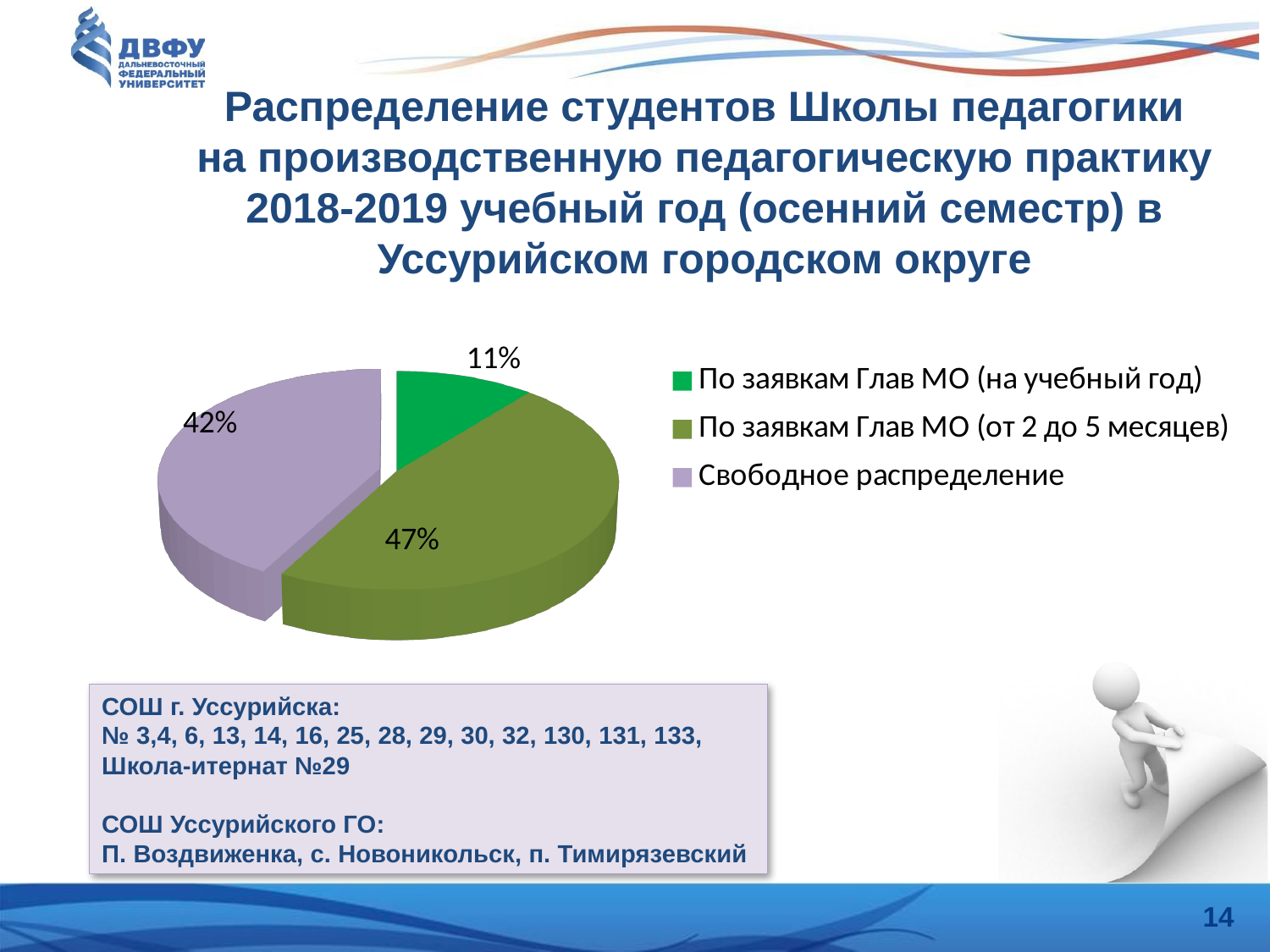
What is the difference in percentage points between "По заявкам Глав МО (от 2 до 5 месяцев)" and "Свободное распределение"? 5 What kind of chart is shown on the slide? Pie chart What colour is the slice for "Свободное распределение"? Purple What share of the pie does "По заявкам Глав МО (на учебный год)" have? 11% Which category has the smallest slice of the pie? По заявкам Глав МО (на учебный год) Which category has the largest slice of the pie? По заявкам Глав МО (от 2 до 5 месяцев) How many slices does the pie chart have? 3 How many entries does the legend list? 3 Which is larger: the slice for "Свободное распределение" or the slice for "По заявкам Глав МО (на учебный год)"? Свободное распределение What is the difference in percentage points between "Свободное распределение" and "По заявкам Глав МО (на учебный год)"? 31 What share of the pie does "По заявкам Глав МО (от 2 до 5 месяцев)" have? 47% What share of the pie does "Свободное распределение" have? 42%